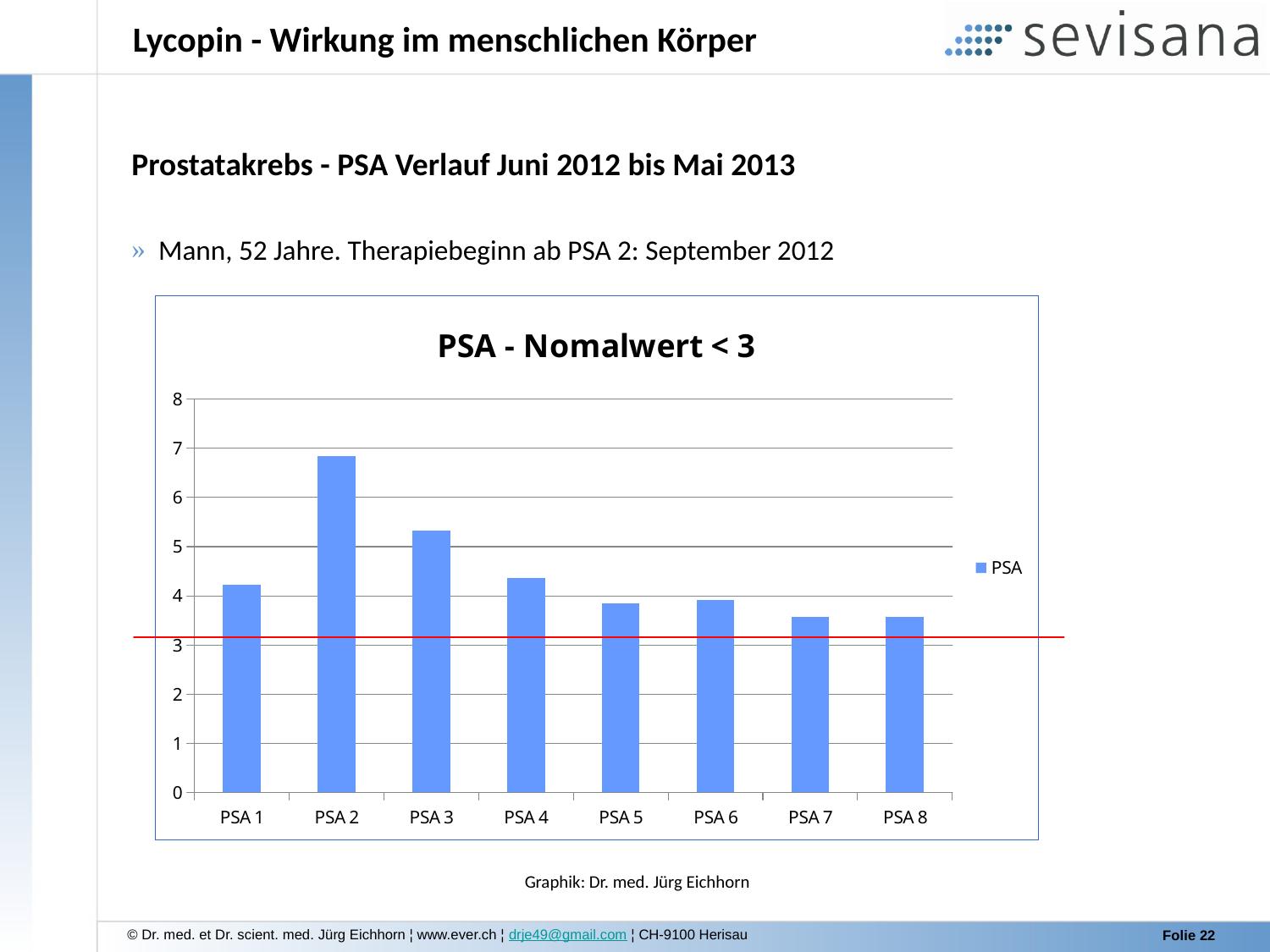
How many series does the chart legend list? 1 Is the value for PSA 2 greater or less than 6? greater From PSA 2 to PSA 8, do the values generally rise or fall? fall How many categories (bars) are shown on the x axis of the chart? 8 Which category has the highest PSA value? PSA 2 Is the value for PSA 8 greater or less than 3? greater Is the value for PSA 3 greater or less than 5? greater What is the title of the chart? PSA - Nomalwert < 3 Which is larger, the value for PSA 1 or the value for PSA 3? PSA 3 What type of chart is shown on the slide? bar chart Which is larger, the value for PSA 2 or the value for PSA 3? PSA 2